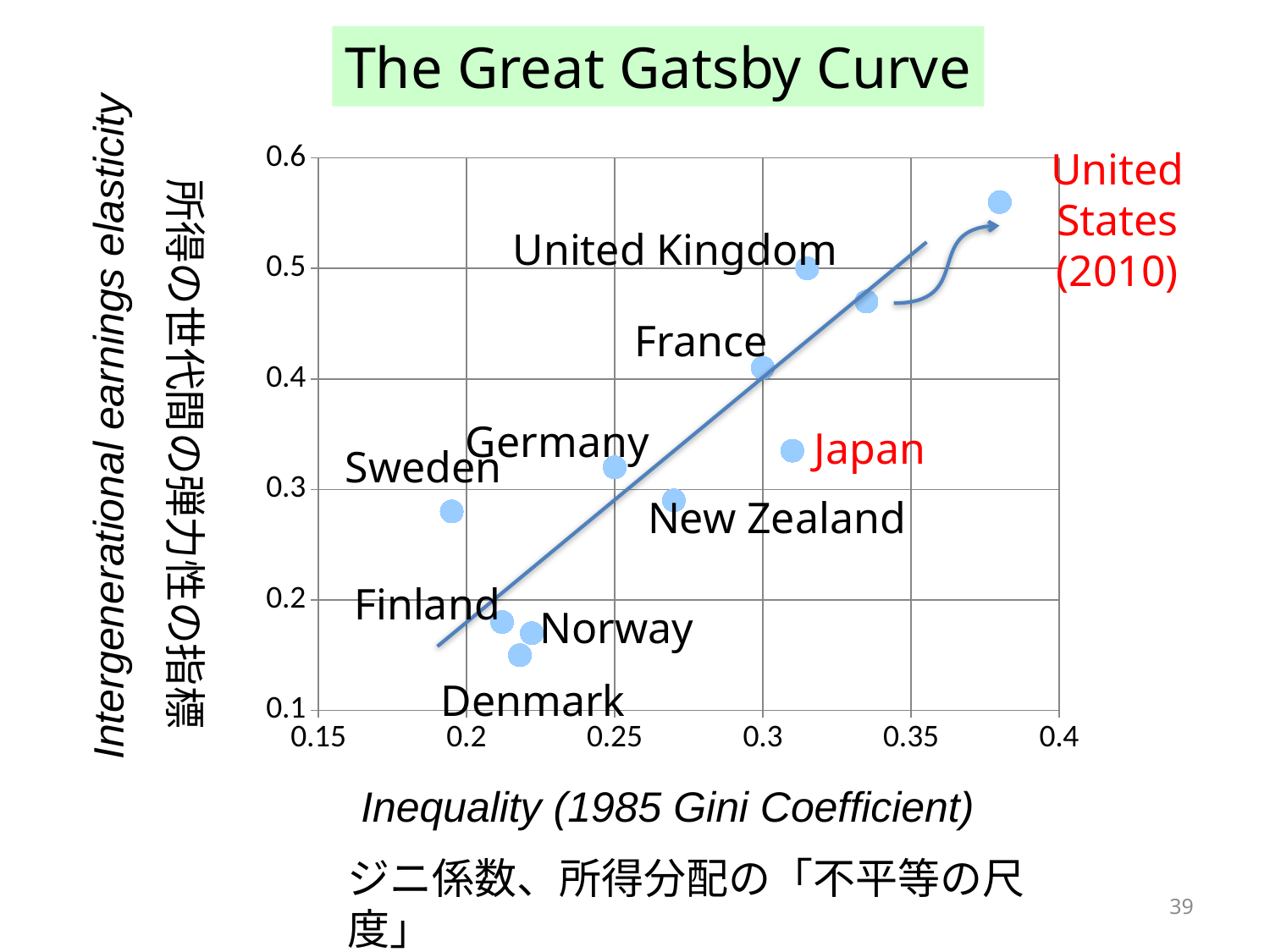
What is the title of the chart? The Great Gatsby Curve What is the label of the x axis? Inequality (1985 Gini Coefficient) Is the intergenerational earnings elasticity for Finland greater or less than 0.2? less What kind of chart is shown on the slide? scatter chart Is the intergenerational earnings elasticity for Sweden greater or less than 0.3? less Is the 1985 Gini coefficient for United States (2010) greater or less than 0.35? greater Which country has the lowest intergenerational earnings elasticity? Denmark Which has a higher intergenerational earnings elasticity, United Kingdom or France? United Kingdom As the Gini coefficient increases along the x axis, does intergenerational earnings elasticity generally rise or fall? rise Which country has the lowest 1985 Gini coefficient? Sweden Which country has the highest intergenerational earnings elasticity? United States (2010)